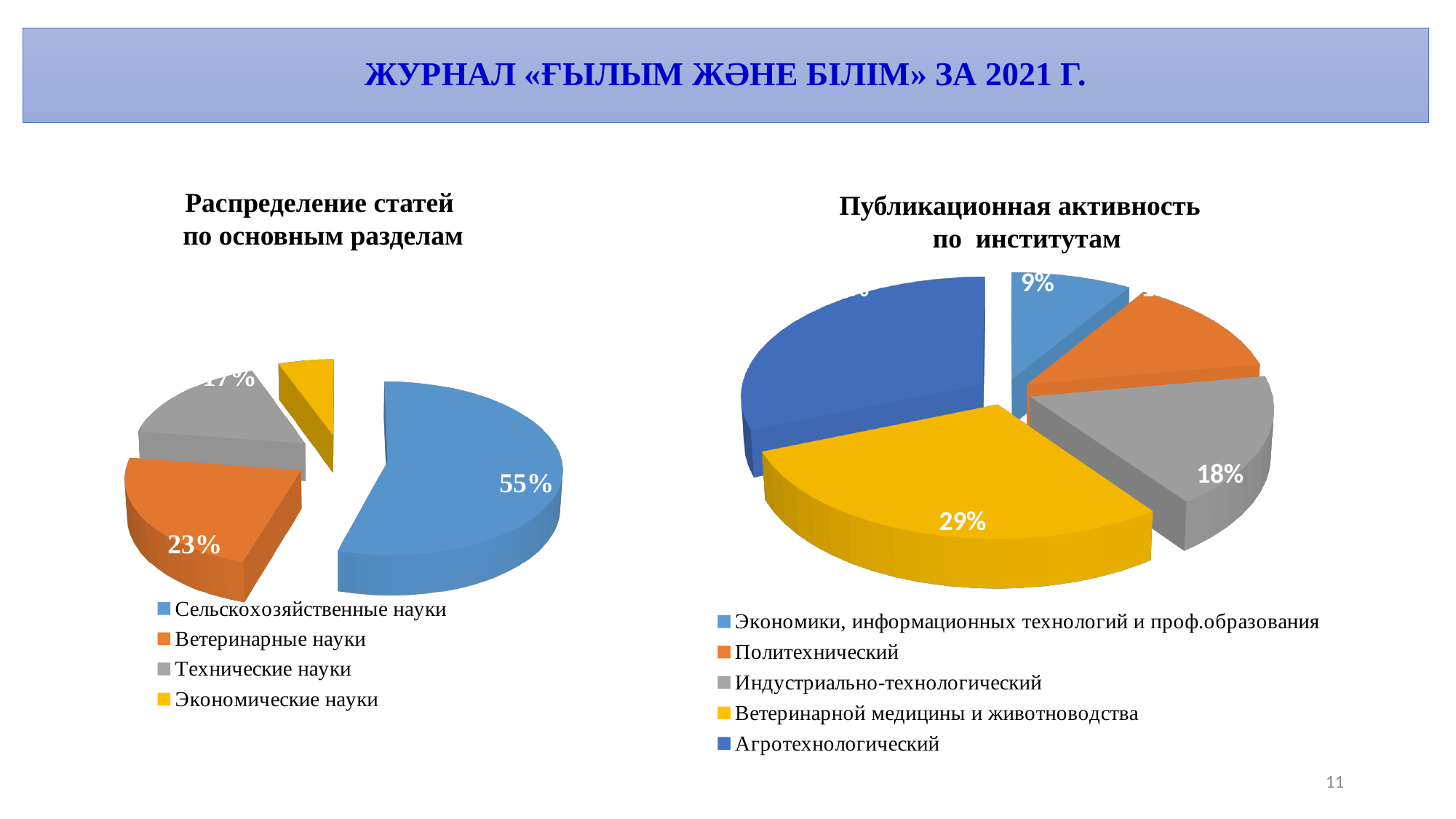
In the chart 'Распределение статей по основным разделам', what percentage is shown for Ветеринарные науки? 23% In the chart 'Распределение статей по основным разделам', what is the difference in percentage points between Сельскохозяйственные науки and Ветеринарные науки? 32 percentage points How many categories does the legend of the chart 'Распределение статей по основным разделам' list? 4 In the chart 'Распределение статей по основным разделам', what percentage is shown for Технические науки? 17% In the chart 'Распределение статей по основным разделам', what percentage is shown for Сельскохозяйственные науки? 55% In the chart 'Публикационная активность по институтам', which is larger: the share for Индустриально-технологический or for Экономики, информационных технологий и проф.образования? Индустриально-технологический In the chart 'Публикационная активность по институтам', what percentage is shown for Ветеринарной медицины и животноводства? 29% What type of chart is 'Публикационная активность по институтам'? Pie chart In the chart 'Публикационная активность по институтам', what percentage is shown for Индустриально-технологический? 18% In the chart 'Распределение статей по основным разделам', which category has the smallest share? Экономические науки In the chart 'Распределение статей по основным разделам', which category has the largest share? Сельскохозяйственные науки In the chart 'Публикационная активность по институтам', what percentage is shown for Экономики, информационных технологий и проф.образования? 9%